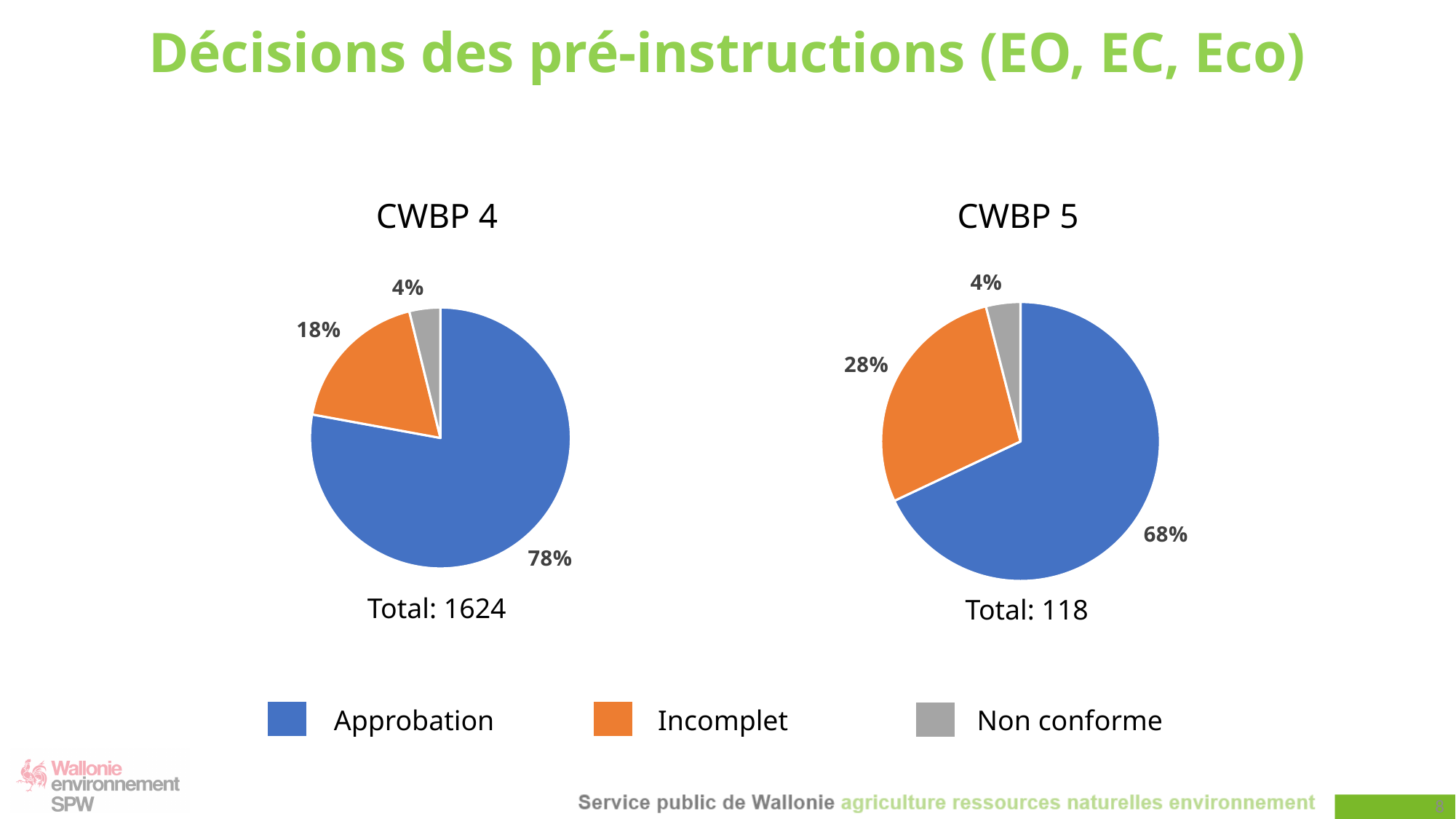
In the CWBP 4 chart, which category has the largest slice? Approbation In the CWBP 4 chart, what share of decisions is Approbation? 78% What type of chart is used for CWBP 4 and CWBP 5? Pie chart In the CWBP 5 chart, what share of decisions is Approbation? 68% In the CWBP 5 chart, which category has the smallest slice? Non conforme How many categories does the legend list? 3 What is the difference between the Approbation share in CWBP 4 and in CWBP 5? 10 percentage points In the CWBP 5 chart, what share of decisions is Incomplet? 28% What is the total number of decisions shown for the CWBP 4 chart? 1624 Is the Incomplet share larger in the CWBP 4 chart or the CWBP 5 chart? CWBP 5 Which colour represents Incomplet in the legend? Orange